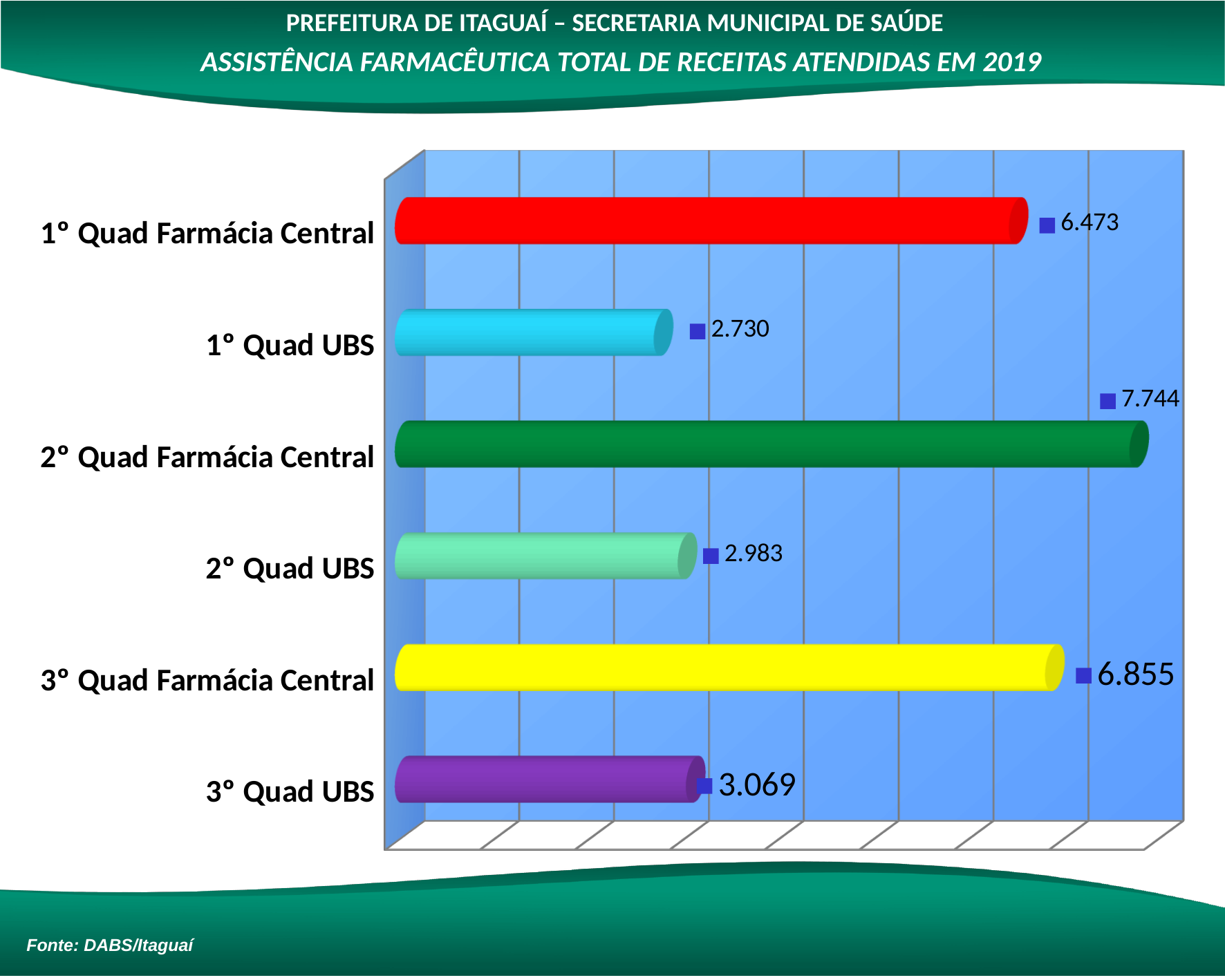
Which is larger, 3° Quad Farmácia Central or 1° Quad Farmácia Central? 3° Quad Farmácia Central Which category has the lowest value? 1° Quad UBS What is the difference between 3° Quad UBS and 1° Quad UBS? 339 What colour is the bar for 2° Quad Farmácia Central? Green What kind of chart is shown on the slide? Bar chart What is the value for 2° Quad UBS? 2.983 What is the value for 3° Quad UBS? 3.069 How many categories are shown in the chart? 6 Which category has the highest value? 2° Quad Farmácia Central What is the value for 1° Quad Farmácia Central? 6.473 What is the difference between 2° Quad Farmácia Central and 1° Quad Farmácia Central? 1.271 What is the value for 1° Quad UBS? 2.730